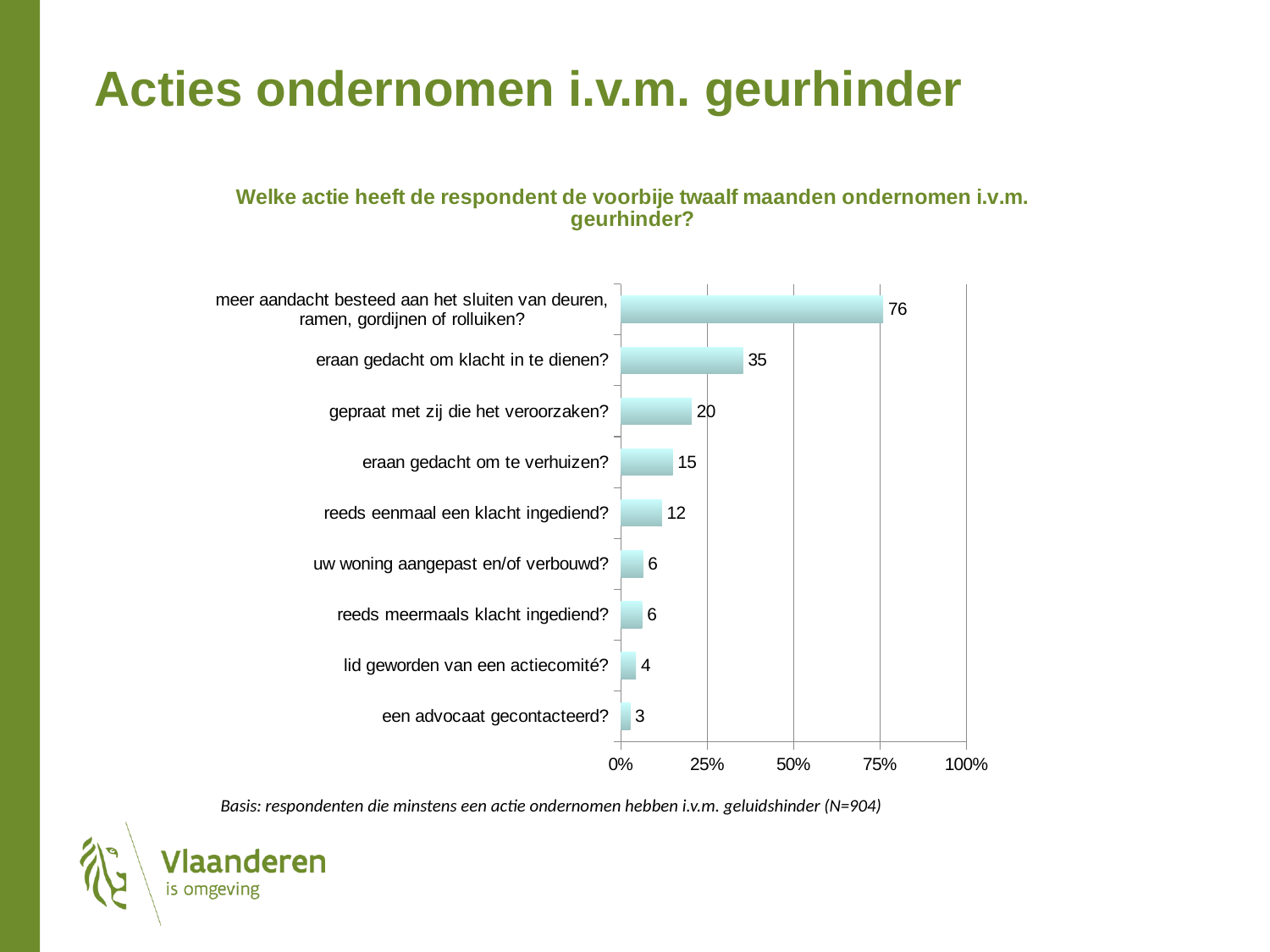
What is the value for "lid geworden van een actiecomité?"? 4 What is the value for "een advocaat gecontacteerd?"? 3 Which category has the highest value? meer aandacht besteed aan het sluiten van deuren, ramen, gordijnen of rolluiken? How many categories are shown in the chart? 9 What is the highest value shown on the x axis? 100% What is the value for "eraan gedacht om klacht in te dienen?"? 35 What is the value for "gepraat met zij die het veroorzaken?"? 20 Which category has the lowest value? een advocaat gecontacteerd? What kind of chart is shown on the slide? bar chart What is the difference between the values for "meer aandacht besteed aan het sluiten van deuren, ramen, gordijnen of rolluiken?" and "eraan gedacht om klacht in te dienen?"? 41 Is the value for "meer aandacht besteed aan het sluiten van deuren, ramen, gordijnen of rolluiken?" greater or less than 50%? greater Which is larger: the value for "eraan gedacht om te verhuizen?" or the value for "reeds eenmaal een klacht ingediend?"? eraan gedacht om te verhuizen?